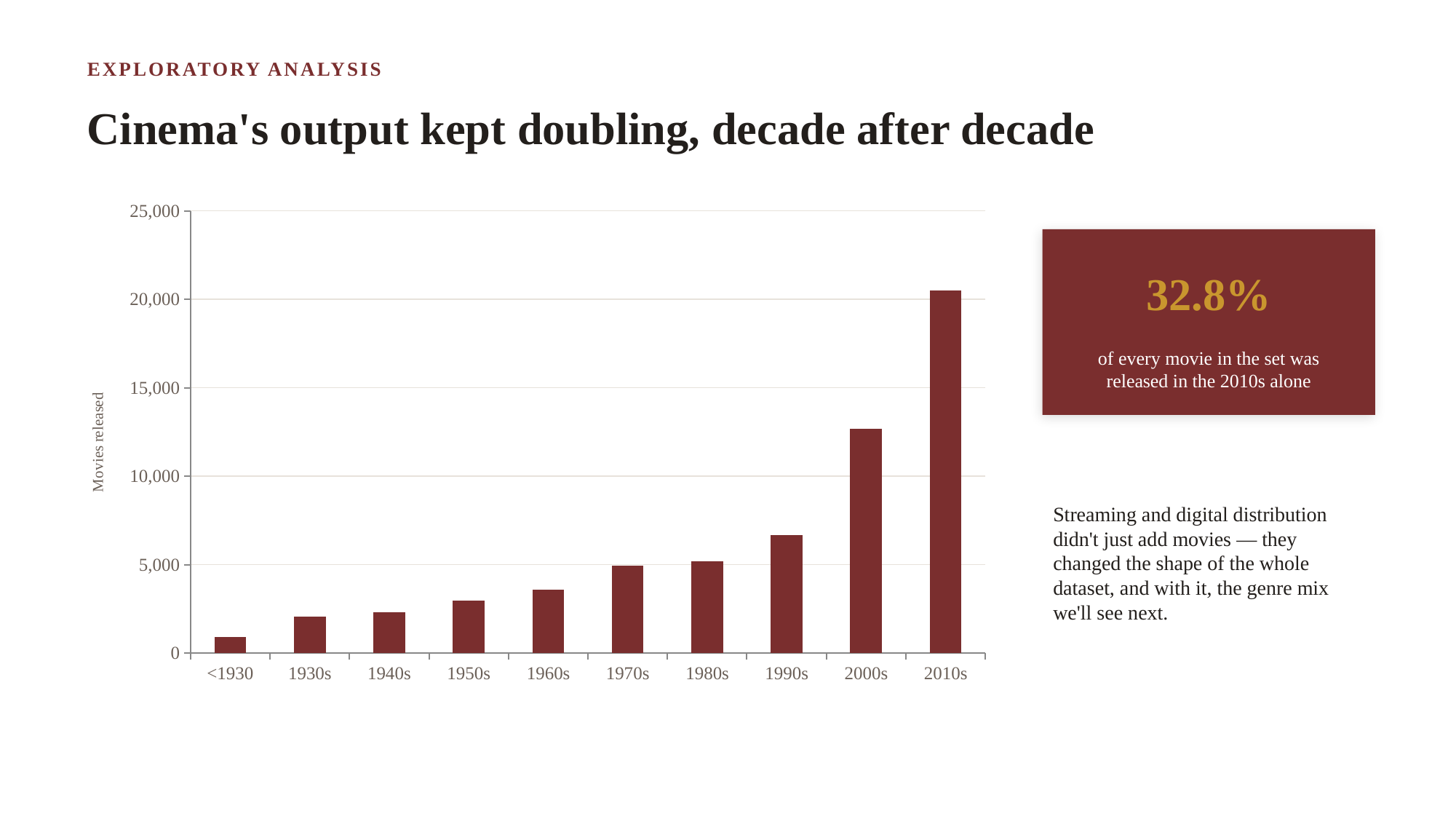
Which has more movies released, the 1980s or the 2000s? 2000s Is the value for the 1990s greater or less than 5,000? greater Is the value for the 2010s greater or less than 20,000? greater Which category has the lowest number of movies released? <1930 Is the value for the 2000s greater or less than 10,000? greater Which decade has the highest number of movies released? 2010s What is the label on the vertical axis of the chart? Movies released Do the values rise or fall from left to right along the x axis? rise How many decade categories are shown on the x axis of the chart? 10 What kind of chart is shown on the slide? bar chart